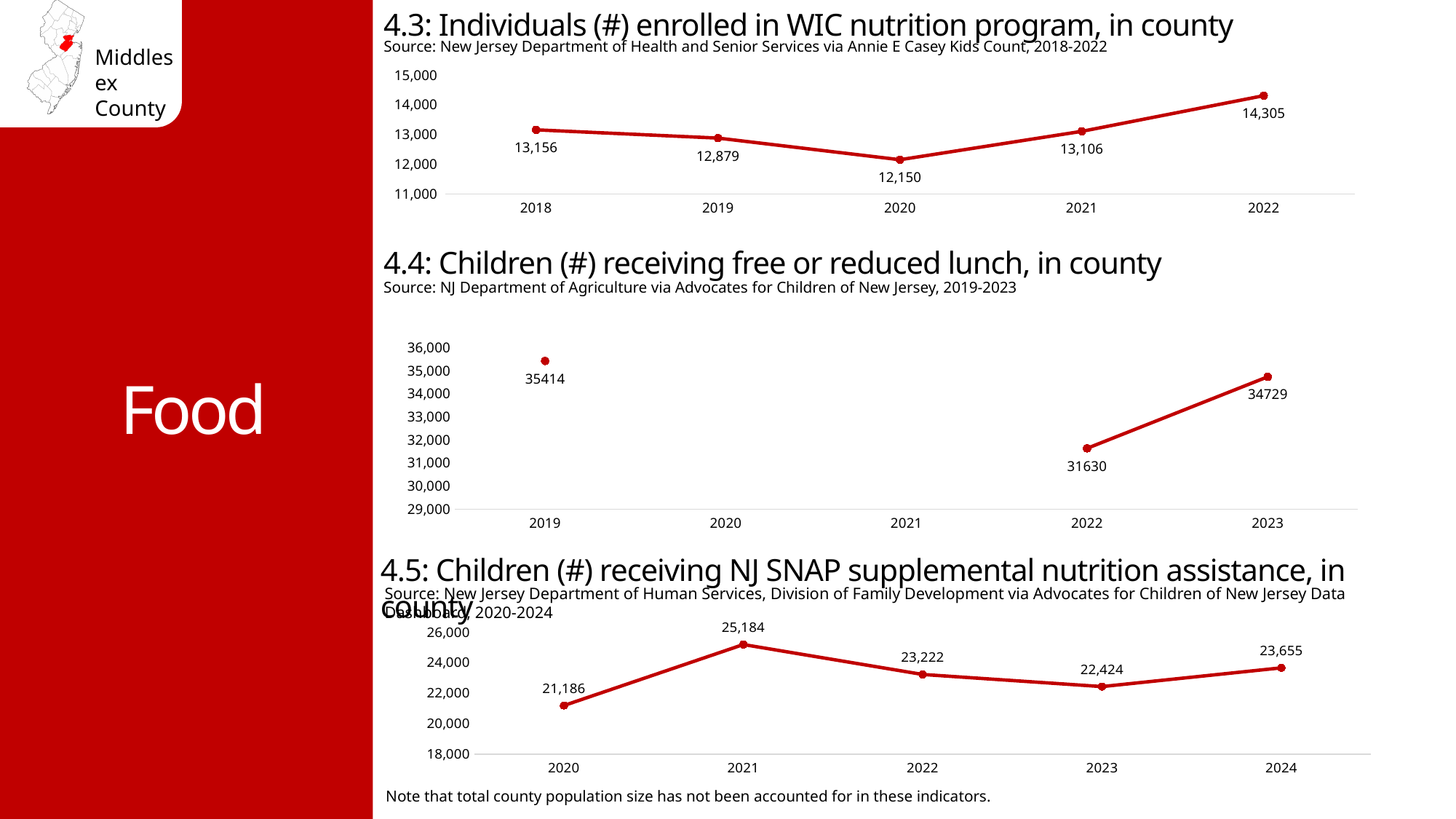
In the chart '4.3: Individuals (#) enrolled in WIC nutrition program, in county', what is the value for 2020? 12,150 In the chart '4.4: Children (#) receiving free or reduced lunch, in county', which year has the lowest plotted value? 2022 What kind of chart is '4.3: Individuals (#) enrolled in WIC nutrition program, in county'? line chart In the chart '4.4: Children (#) receiving free or reduced lunch, in county', is the value for 2019 larger or smaller than the value for 2023? larger In the chart '4.4: Children (#) receiving free or reduced lunch, in county', what is the value for 2022? 31630 In the chart '4.5: Children (#) receiving NJ SNAP supplemental nutrition assistance, in county', which year has the lowest value? 2020 In the chart '4.3: Individuals (#) enrolled in WIC nutrition program, in county', what is the difference between the 2022 and 2018 values? 1,149 In the chart '4.5: Children (#) receiving NJ SNAP supplemental nutrition assistance, in county', is the value for 2023 greater or less than 24,000? less In the chart '4.5: Children (#) receiving NJ SNAP supplemental nutrition assistance, in county', what is the value for 2021? 25,184 In the chart '4.3: Individuals (#) enrolled in WIC nutrition program, in county', how many years are plotted? 5 In the chart '4.5: Children (#) receiving NJ SNAP supplemental nutrition assistance, in county', what is the difference between the 2021 and 2020 values? 3,998 In the chart '4.3: Individuals (#) enrolled in WIC nutrition program, in county', which year has the highest value? 2022